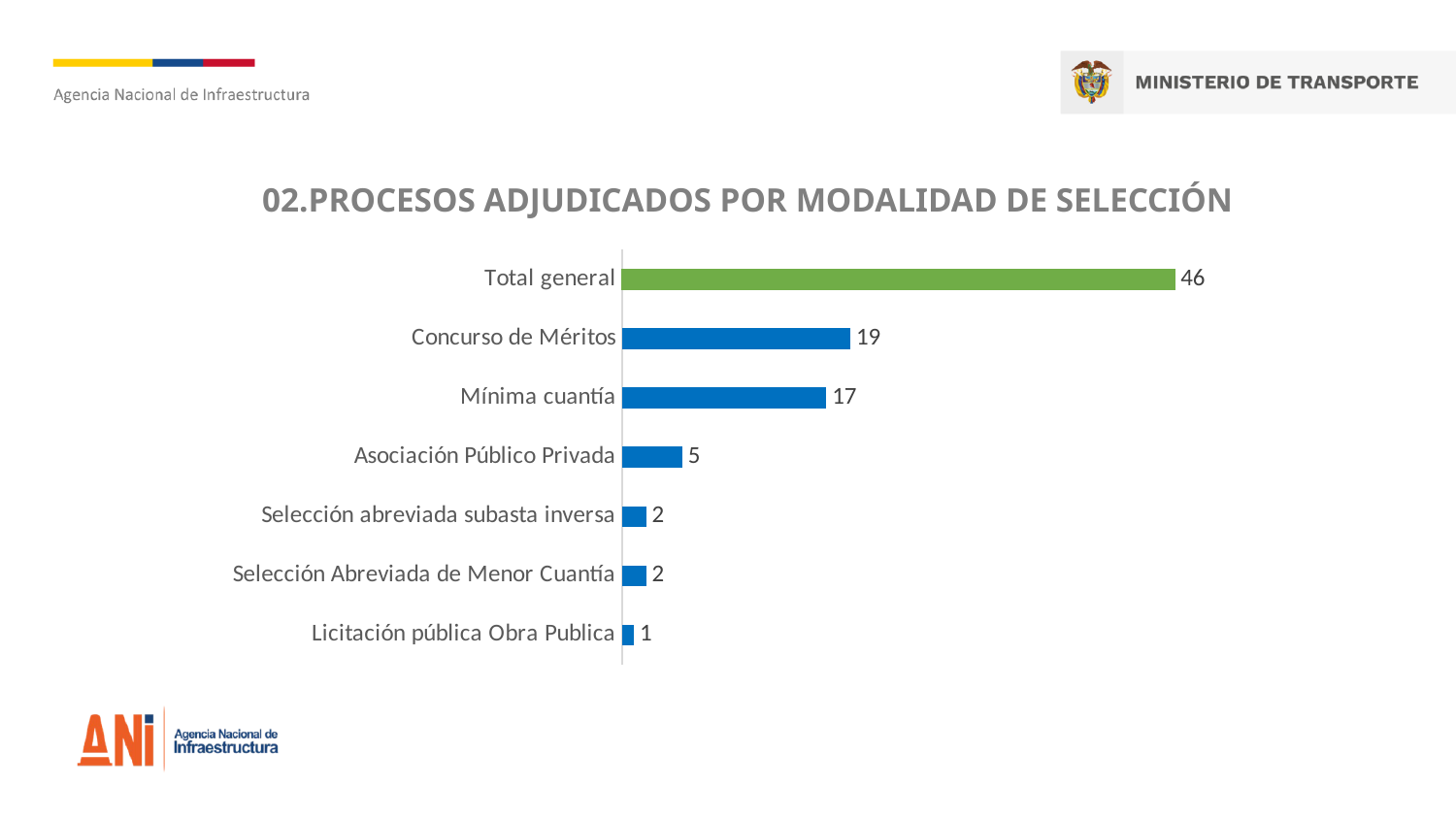
What is the value for Licitación pública Obra Publica? 1 What is the value for Concurso de Méritos? 19 Excluding Total general, which category has the highest value? Concurso de Méritos What is the value for Mínima cuantía? 17 What kind of chart is shown? Bar chart Which is larger, Asociación Público Privada or Selección abreviada subasta inversa? Asociación Público Privada What is the value for Asociación Público Privada? 5 What is the title of the chart? 02.PROCESOS ADJUDICADOS POR MODALIDAD DE SELECCIÓN What is the difference between Concurso de Méritos and Mínima cuantía? 2 Which category has the lowest value? Licitación pública Obra Publica What is the value shown for Total general? 46 How many categories are shown on the chart, including Total general? 7